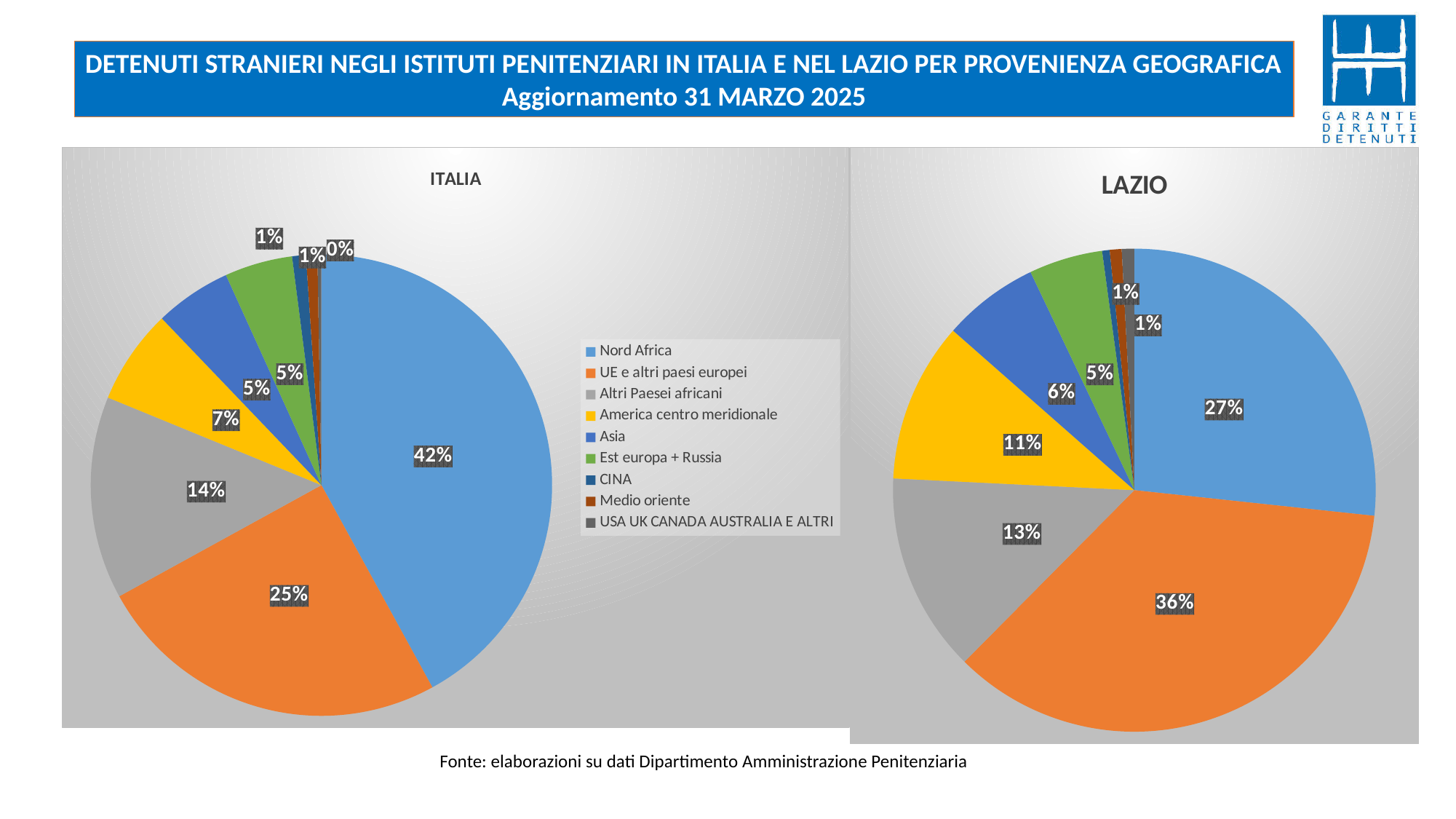
In the LAZIO chart, what share is America centro meridionale? 11% In the LAZIO chart, which is larger: Altri Paesei africani or America centro meridionale? Altri Paesei africani In the LAZIO chart, what share is Nord Africa? 27% In the ITALIA chart, which category has the smallest share? USA UK CANADA AUSTRALIA E ALTRI In the ITALIA chart, what share is Nord Africa? 42% In the ITALIA chart, what share is UE e altri paesi europei? 25% What type of charts are shown on the slide? Pie charts How many categories does the legend list? 9 In the ITALIA chart, which category has the largest share? Nord Africa In the LAZIO chart, which category has the largest share? UE e altri paesi europei In the LAZIO chart, what share is UE e altri paesi europei? 36% In the ITALIA chart, what is the difference between the Nord Africa share and the UE e altri paesi europei share? 17%